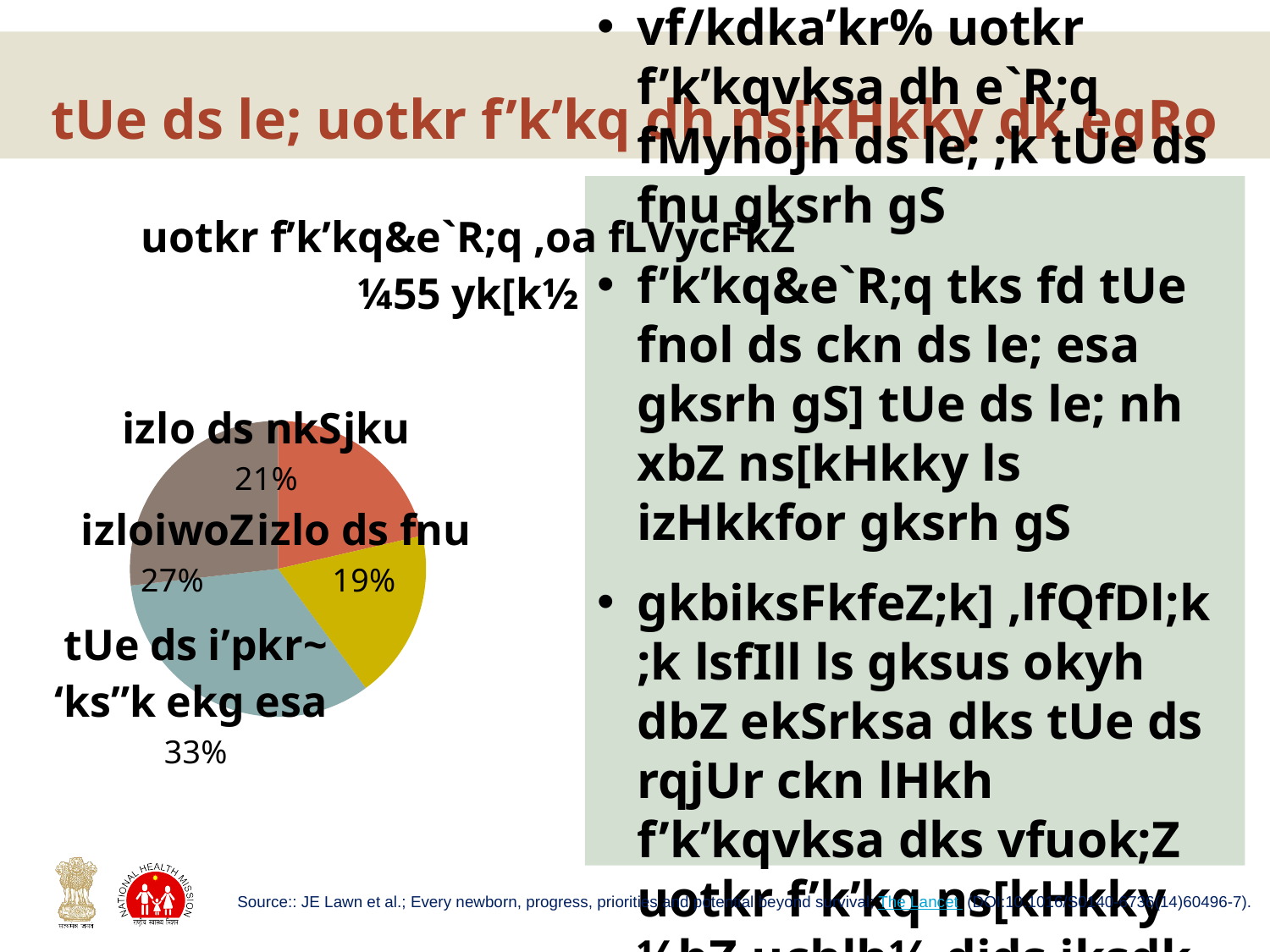
What percentage does the pie chart show for "izloiwoZ"? 27% What percentage does the pie chart show for "tUe ds i'pkr~ 'ks"k ekg esa"? 33% Which slice of the pie chart has the largest share? tUe ds i'pkr~ 'ks"k ekg esa What is the title of the pie chart? uotkr f'k'kq&e`R;q ,oa fLVycFkZ ¼55 yk[k½ What is the combined share of the "izlo ds nkSjku" and "izlo ds fnu" slices? 40% By how many percentage points does the "tUe ds i'pkr~ 'ks"k ekg esa" slice exceed the "izlo ds fnu" slice? 14 percentage points Which slice of the pie chart has the smallest share? izlo ds fnu How many slices does the pie chart have? 4 Which is larger in the pie chart, "izloiwoZ" or "izlo ds nkSjku"? izloiwoZ What percentage does the pie chart show for "izlo ds nkSjku"? 21% What percentage does the pie chart show for "izlo ds fnu"? 19% What kind of chart is shown on the slide? pie chart